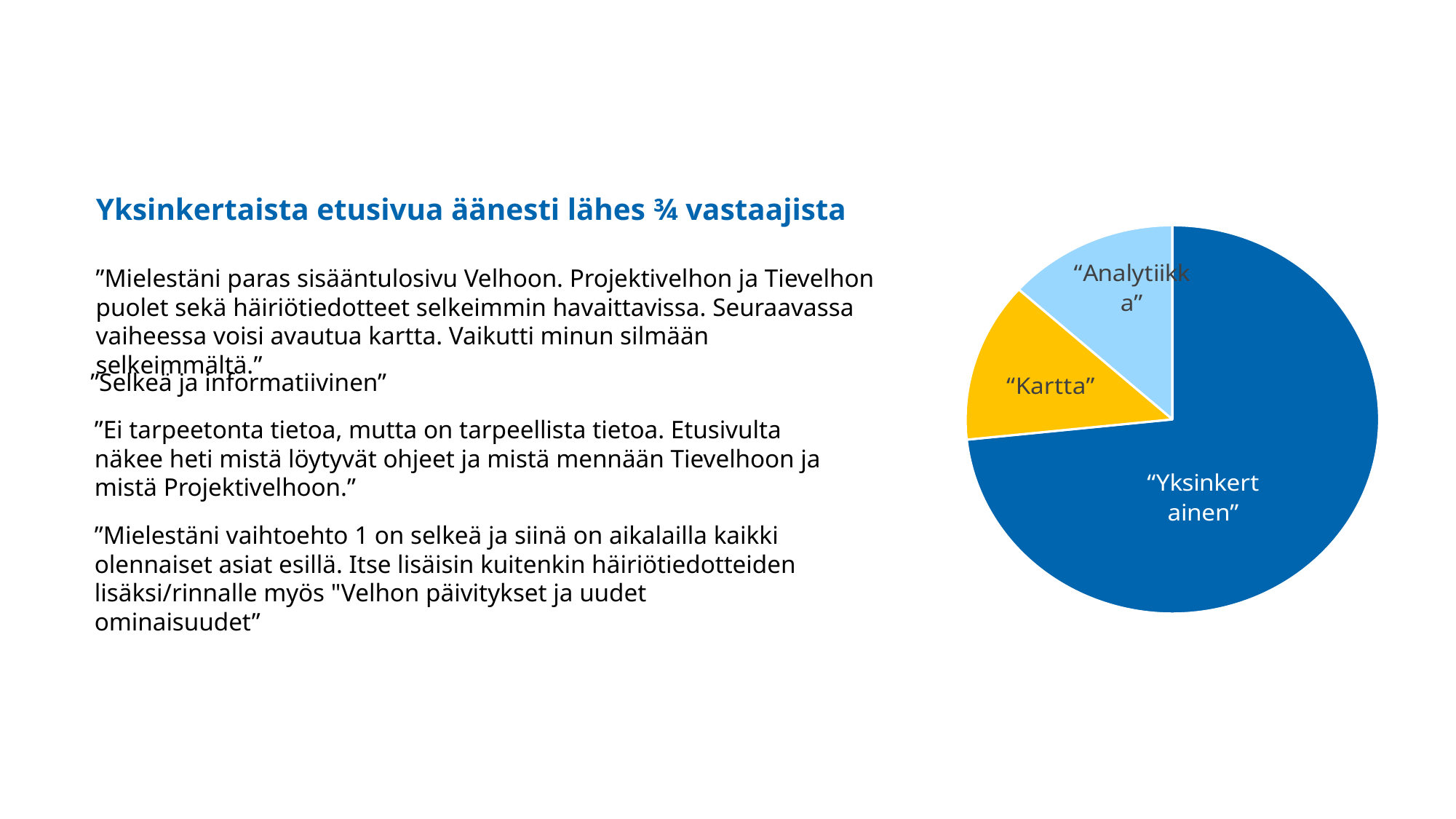
Which is larger in the pie chart, the "Analytiikka" slice or the "Yksinkertainen" slice? "Yksinkertainen" Which slice of the pie chart is coloured light blue? "Analytiikka" Which slice of the pie chart is the largest? "Yksinkertainen" How many slices does the pie chart have? 3 What kind of chart is shown on the slide? pie chart Which is larger in the pie chart, the "Yksinkertainen" slice or the "Kartta" slice? "Yksinkertainen" What colour is the "Kartta" slice in the pie chart? yellow